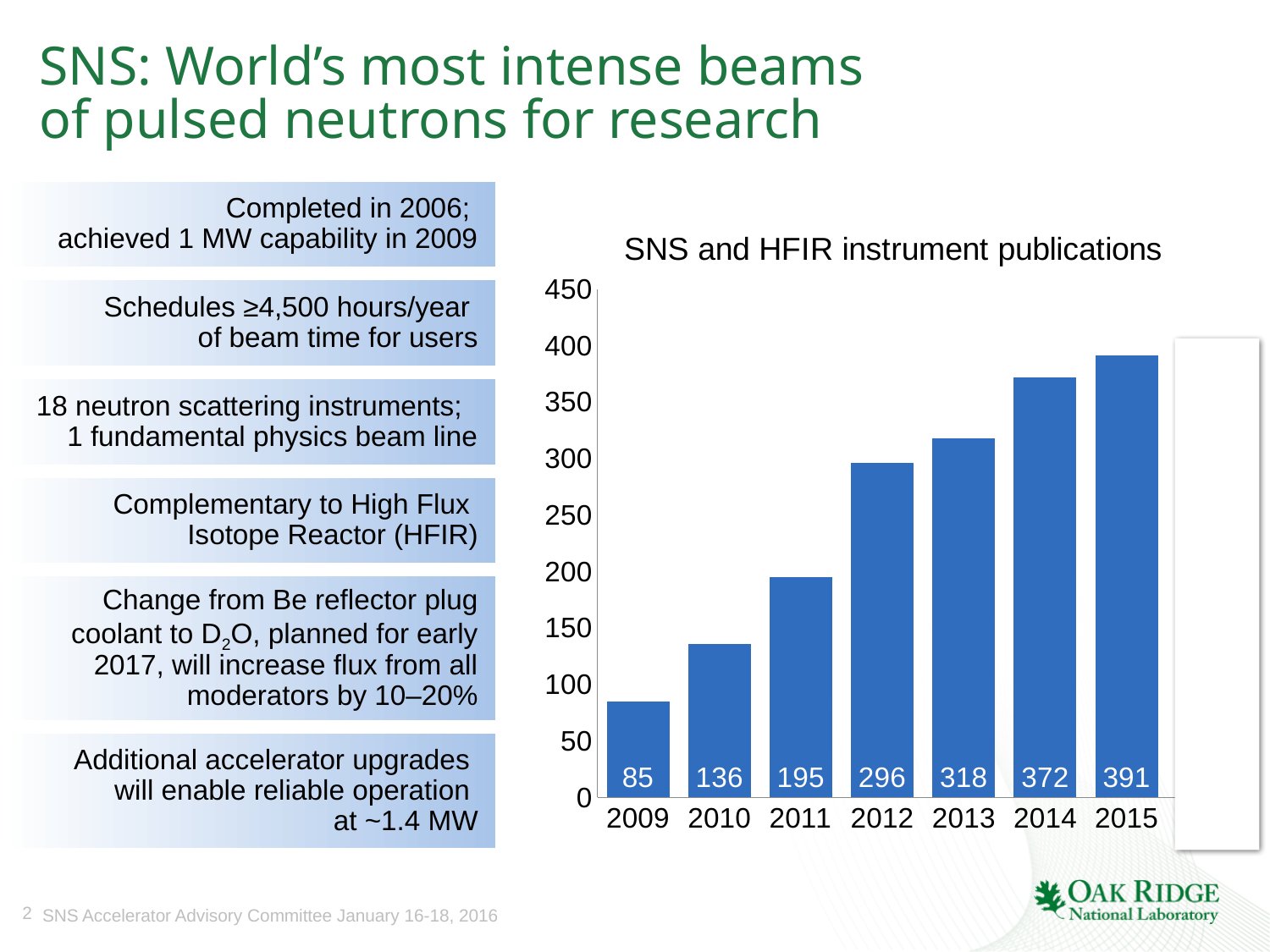
What is the difference in publications between 2015 and 2009? 306 What is the value for 2014 in the publications chart? 372 How many years are shown on the x axis of the chart? 7 What kind of chart is used to show the publications data? Bar chart Do the publication counts rise or fall from 2009 to 2015? Rise Which year had more publications, 2010 or 2013? 2013 What is the number of publications shown for 2009? 85 Which year has the highest number of publications? 2015 Which year has the lowest number of publications? 2009 What is the title of the chart? SNS and HFIR instrument publications What is the number of SNS and HFIR instrument publications in 2012? 296 How many more publications were there in 2012 than in 2011? 101